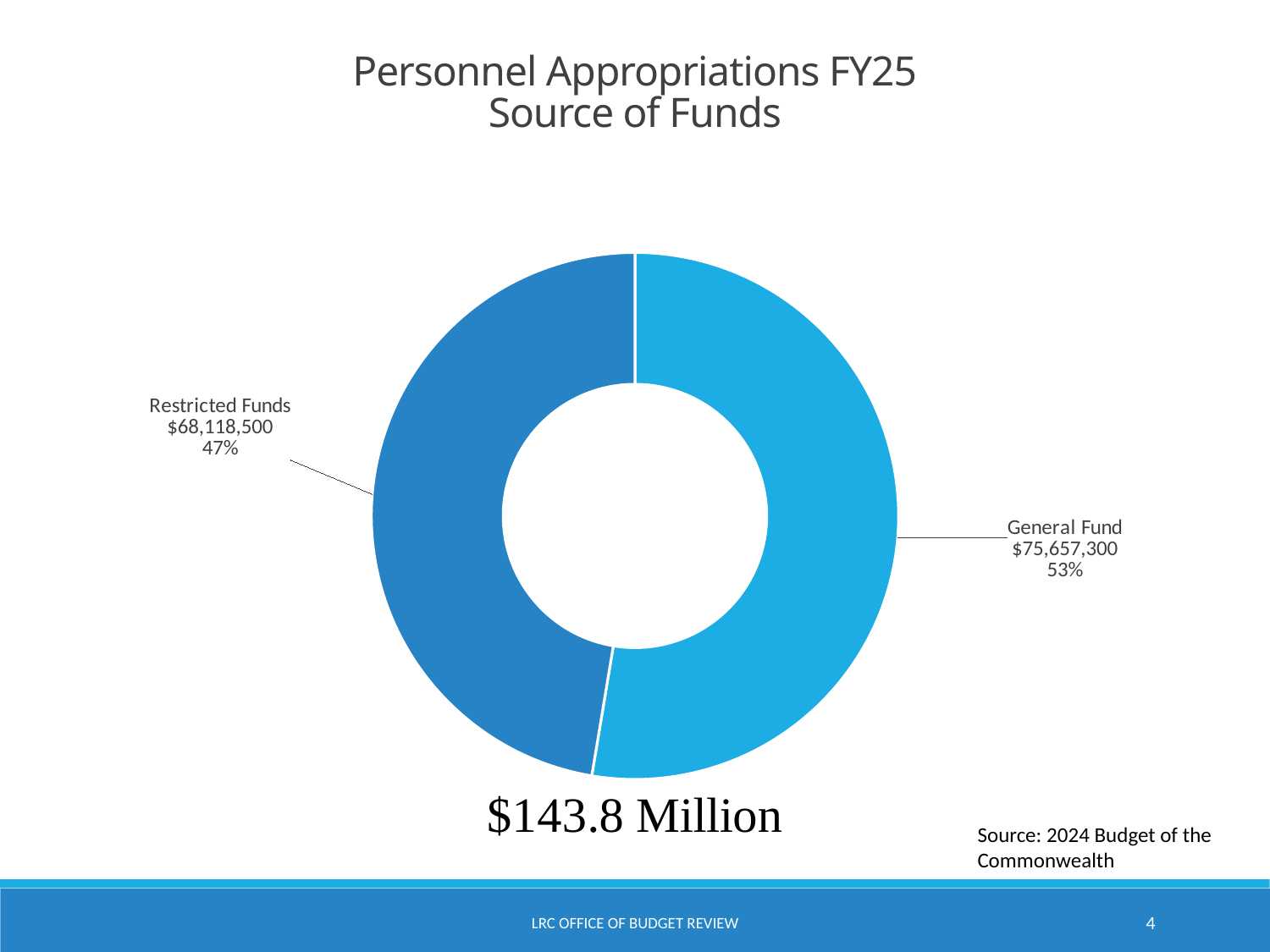
What is the title of the chart? Personnel Appropriations FY25 Source of Funds What is the difference between the General Fund and Restricted Funds values? $7,538,800 What is the value for General Fund? $75,657,300 Which is larger, General Fund or Restricted Funds? General Fund Which source of funds is the smallest? Restricted Funds What is the value for Restricted Funds? $68,118,500 What share of the chart does General Fund represent? 53% Which source of funds is the largest? General Fund What share of the chart does Restricted Funds represent? 47% What kind of chart is shown on the slide? Pie chart (doughnut) How many categories are shown in the chart? 2 What total amount is printed below the chart? $143.8 Million